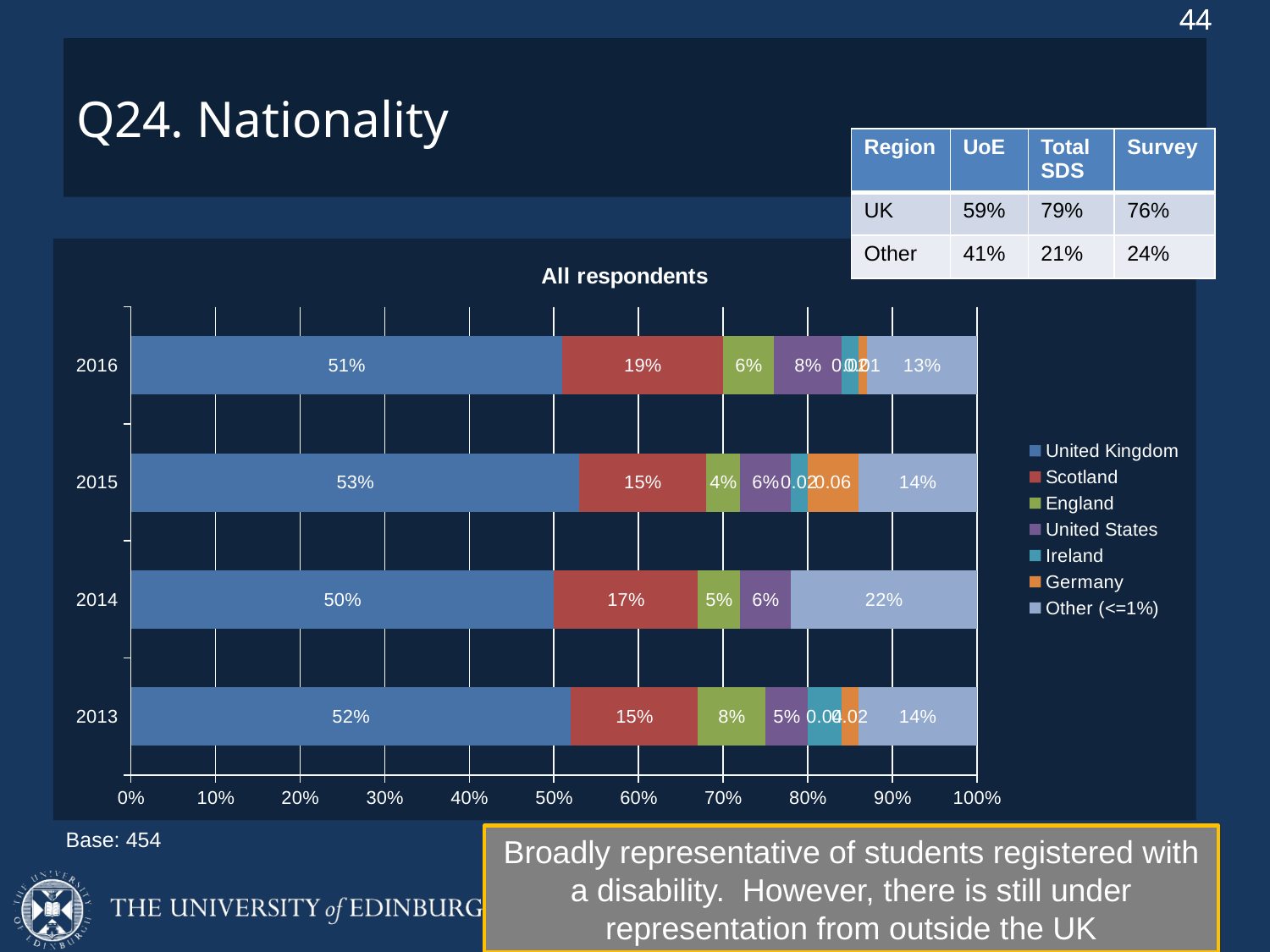
Which year has the highest United Kingdom share? 2015 What is the United Kingdom share for 2015? 53% Which year has the lowest United Kingdom share? 2014 How many series does the chart legend list? 7 What type of chart is shown on the slide? stacked bar chart What is the difference between the Scotland share in 2016 and in 2015? 4% What is the England share for 2013? 8% What is the Other (<=1%) share for 2014? 22% What is the title of the chart? All respondents Is the United States share larger in 2016 or in 2014? 2016 What is the Scotland share for 2016? 19% How many years are shown on the chart's vertical axis? 4